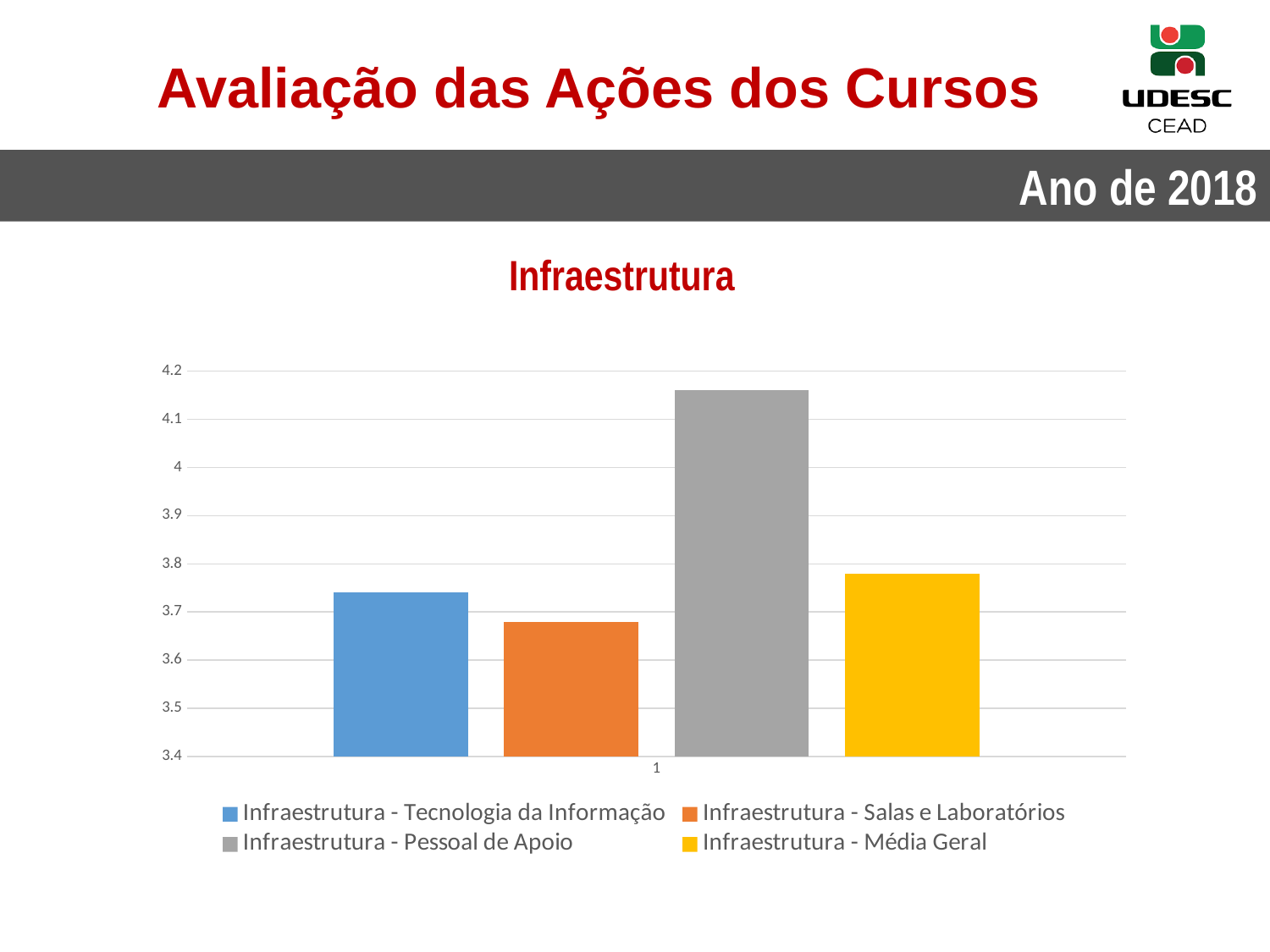
Which series has the highest bar? Infraestrutura - Pessoal de Apoio Which is larger, the value for Infraestrutura - Pessoal de Apoio or Infraestrutura - Média Geral? Infraestrutura - Pessoal de Apoio Is the value for Infraestrutura - Salas e Laboratórios greater or less than 3.6? greater Which series has the lowest bar? Infraestrutura - Salas e Laboratórios Is the value for Infraestrutura - Média Geral greater or less than 3.7? greater Is the value for Infraestrutura - Tecnologia da Informação greater or less than 3.8? less What is the title of the chart? Infraestrutura What kind of chart is shown on the slide? bar chart Which is larger, the value for Infraestrutura - Tecnologia da Informação or Infraestrutura - Salas e Laboratórios? Infraestrutura - Tecnologia da Informação What colour is the bar for Infraestrutura - Média Geral? yellow How many series does the legend list? 4